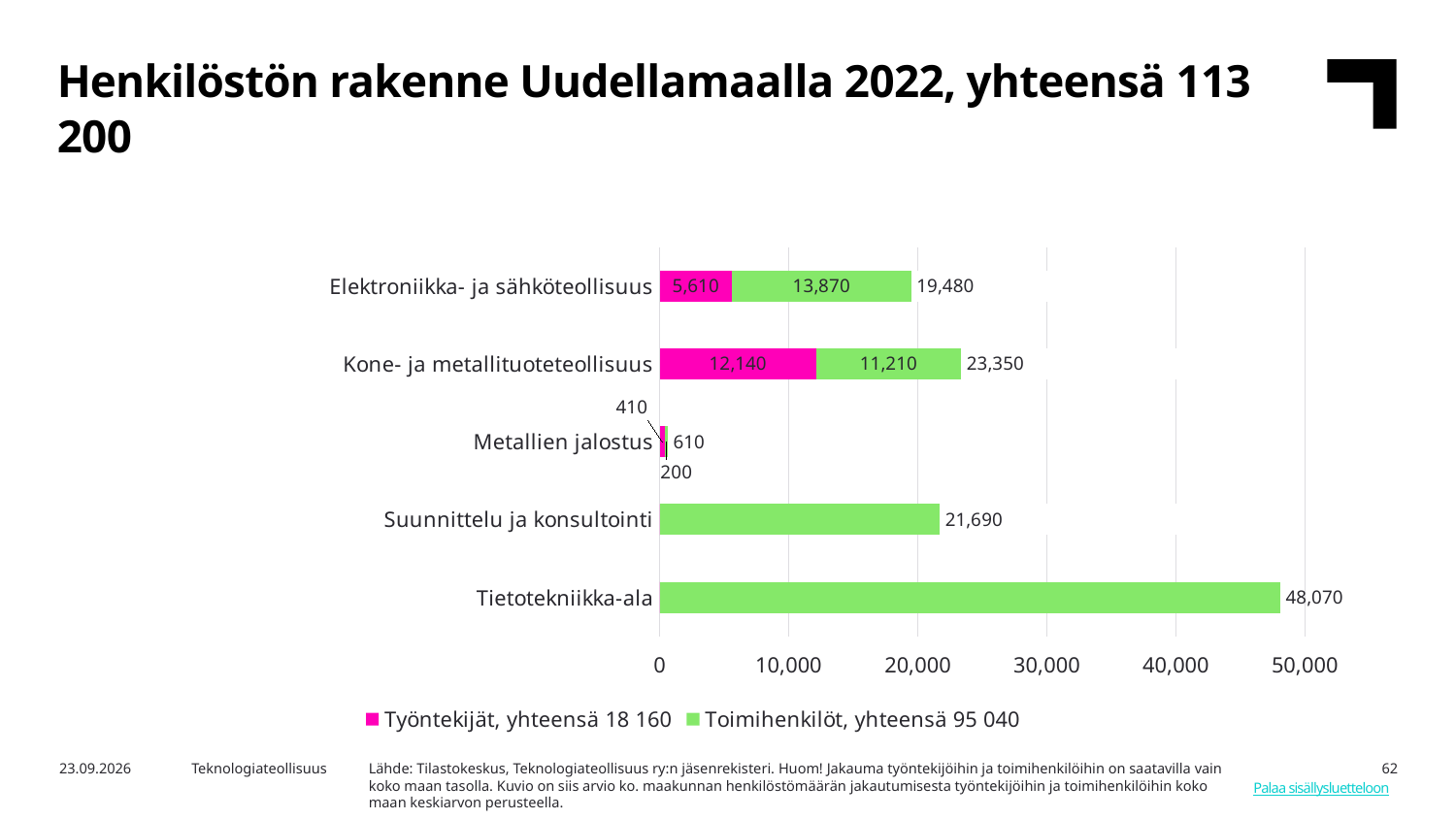
How many categories are shown on the chart? 5 Is the total for Tietotekniikka-ala greater or less than 40,000? greater Which is larger: the total for Suunnittelu ja konsultointi or the total for Kone- ja metallituoteteollisuus? Kone- ja metallituoteteollisuus What is the difference between the Työntekijät and Toimihenkilöt values for Elektroniikka- ja sähköteollisuus? 8,260 What is the total for Tietotekniikka-ala? 48,070 What is the Toimihenkilöt value for Elektroniikka- ja sähköteollisuus? 13,870 How many series does the legend list? 2 Which category has the highest total? Tietotekniikka-ala What is the total of the stacked bar for Kone- ja metallituoteteollisuus? 23,350 What is the Työntekijät value for Kone- ja metallituoteteollisuus? 12,140 What type of chart is shown on the slide? Stacked bar chart Which category has the lowest total? Metallien jalostus